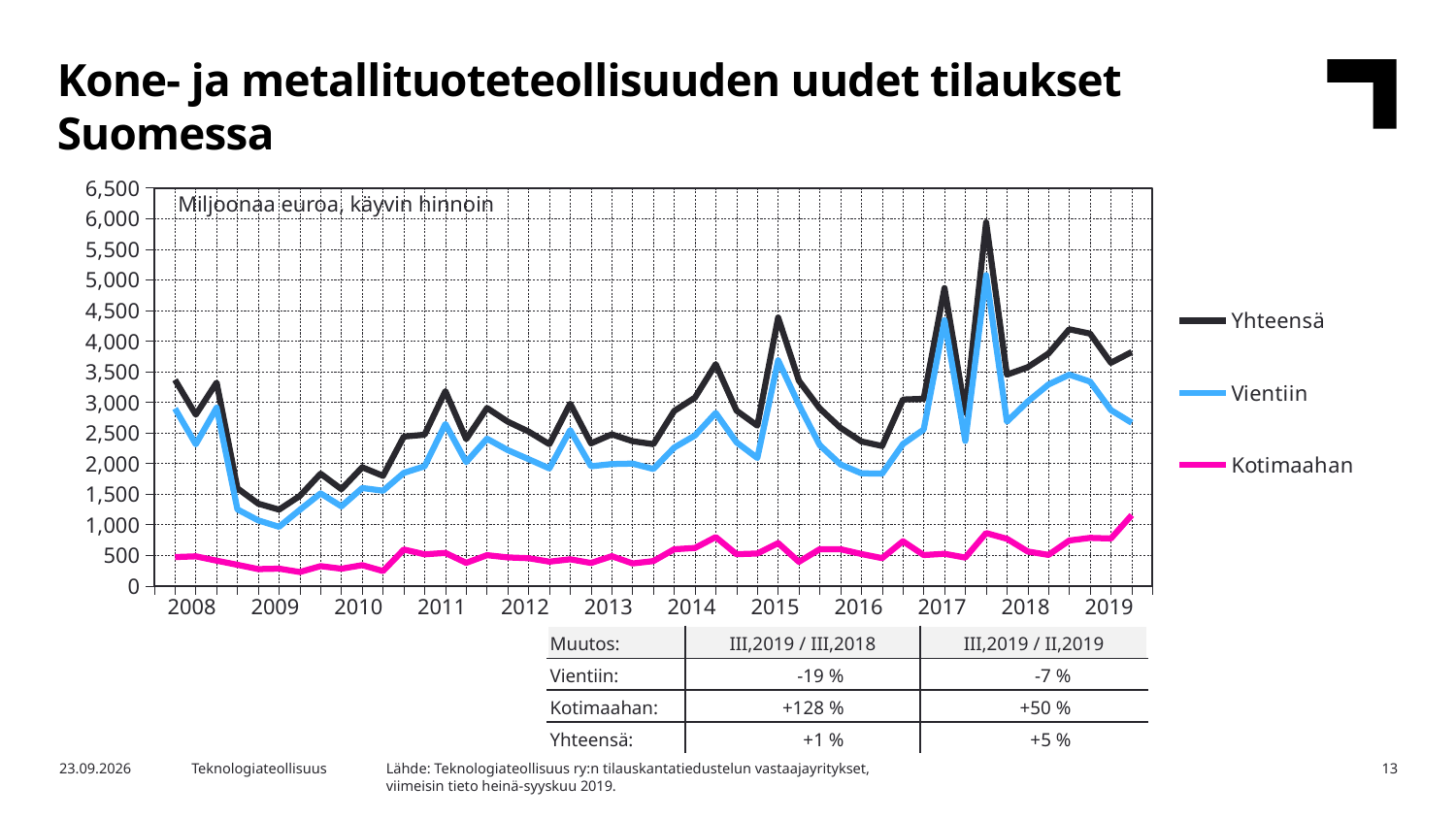
Which is larger at the start of 2008, the Vientiin value or the Kotimaahan value? Vientiin Which series has the lowest values throughout the chart? Kotimaahan According to the table below the chart, what is the change in Vientiin for III,2019 / III,2018? -19 % What unit is stated in the text inside the chart area? Miljoonaa euroa, käyvin hinnoin Is the Kotimaahan value at the start of 2008 greater or less than 1,000? less Does the Yhteensä line rise or fall from the start of 2008 to 2009? fall Which series has the highest values throughout the chart? Yhteensä Is the peak value of the Yhteensä line greater or less than 5,500? greater What kind of chart is shown on the slide? line chart What are the three series named in the chart legend? Yhteensä, Vientiin, Kotimaahan Is the Vientiin value at the start of 2008 greater or less than 2,500? greater How many series does the chart legend list? 3